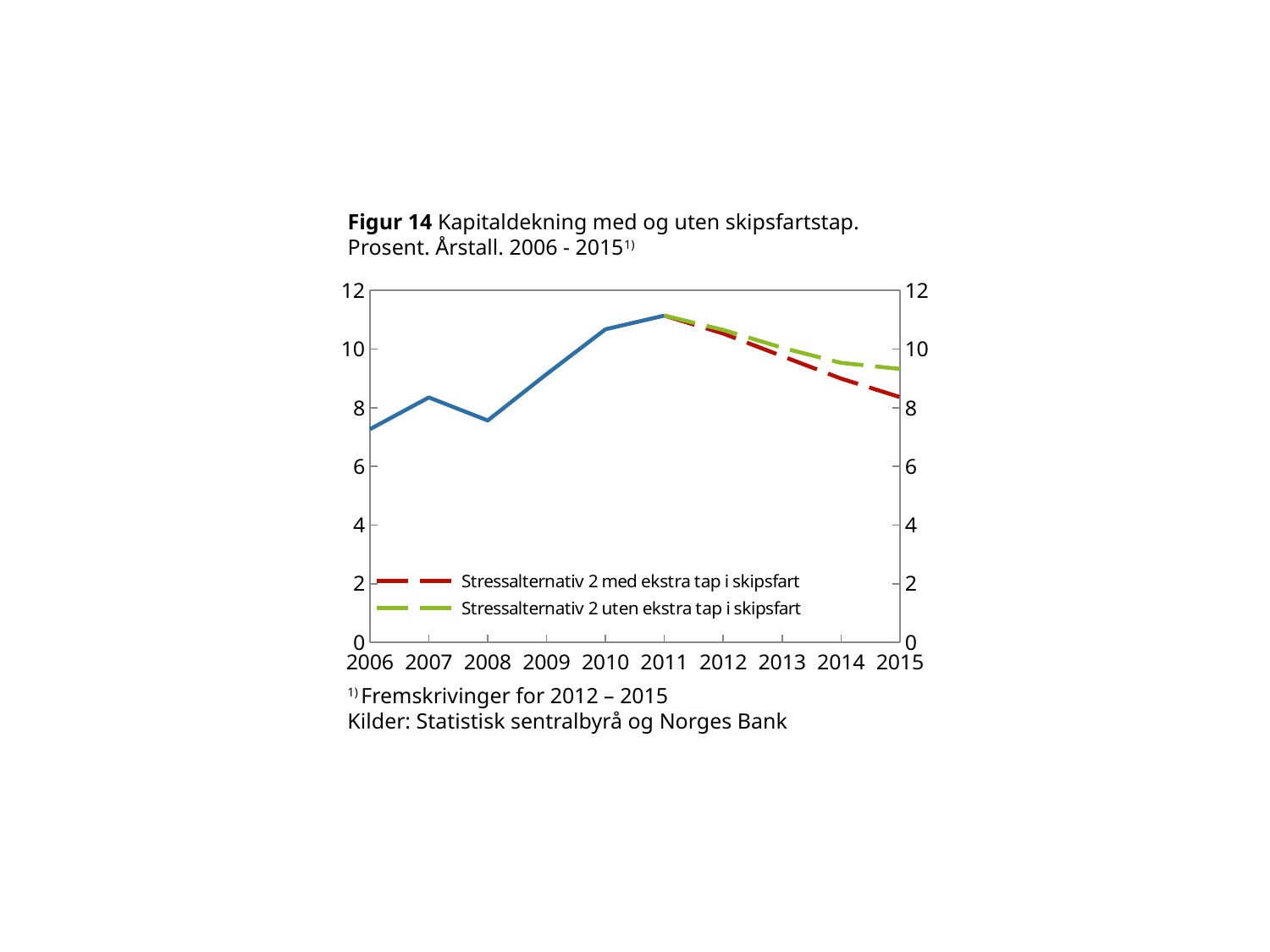
In which year does the chart reach its highest value? 2011 Is the 2015 value for 'Stressalternativ 2 med ekstra tap i skipsfart' greater or less than 10? less Is the 2015 value for 'Stressalternativ 2 uten ekstra tap i skipsfart' greater or less than 8? greater Is the value for 2011 greater or less than 10? greater What kind of chart is shown in Figur 14? line chart How many years are shown on the x axis? 10 Do the dashed lines rise or fall from 2011 to 2015? fall According to the footnote, which years are projections (fremskrivinger)? 2012 – 2015 In 2015, which series is higher: 'Stressalternativ 2 med ekstra tap i skipsfart' or 'Stressalternativ 2 uten ekstra tap i skipsfart'? Stressalternativ 2 uten ekstra tap i skipsfart Does the line rise or fall from 2008 to 2011? rise How many series does the legend list? 2